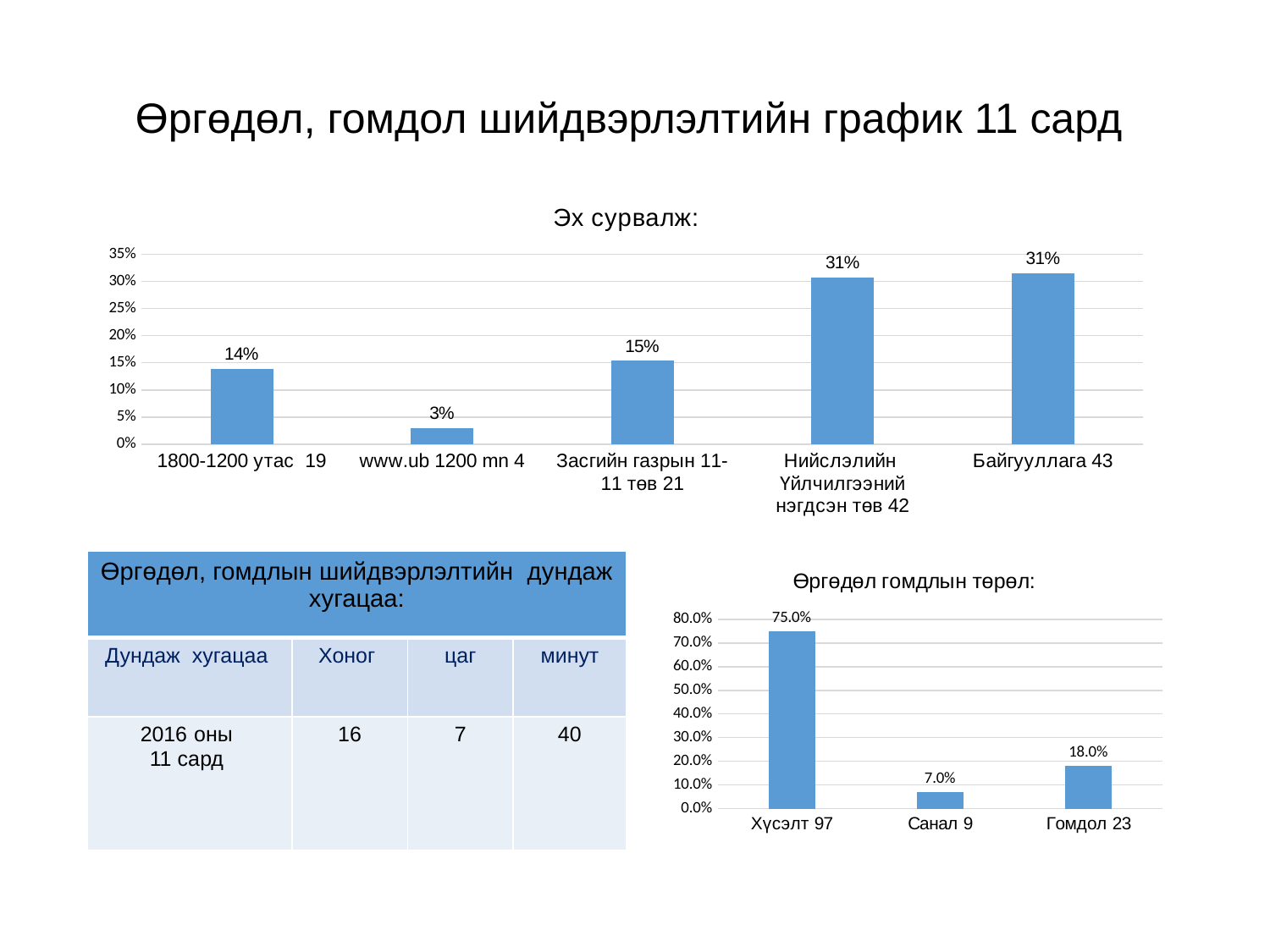
In the "Эх сурвалж:" chart, what is the difference between "Засгийн газрын 11-11 төв 21" and "1800-1200 утас 19"? 1% In the "Өргөдөл гомдлын төрөл:" chart, what is the value for "Хүсэлт 97"? 75.0% In the "Өргөдөл гомдлын төрөл:" chart, which category has the highest value? Хүсэлт 97 In the "Эх сурвалж:" chart, which is larger: "Нийслэлийн Үйлчилгээний нэгдсэн төв 42" or "1800-1200 утас 19"? Нийслэлийн Үйлчилгээний нэгдсэн төв 42 In the "Өргөдөл гомдлын төрөл:" chart, what is the value for "Гомдол 23"? 18.0% In the "Эх сурвалж:" chart, which category has the lowest value? www.ub 1200 mn 4 In the "Эх сурвалж:" chart, what is the value for "www.ub 1200 mn 4"? 3% In the "Эх сурвалж:" chart, what is the value for "Байгууллага 43"? 31% How many categories are shown in the "Эх сурвалж:" chart? 5 How many categories are shown in the "Өргөдөл гомдлын төрөл:" chart? 3 In the "Өргөдөл гомдлын төрөл:" chart, what is the difference between "Гомдол 23" and "Санал 9"? 11.0% What type of chart is the "Эх сурвалж:" chart? bar chart